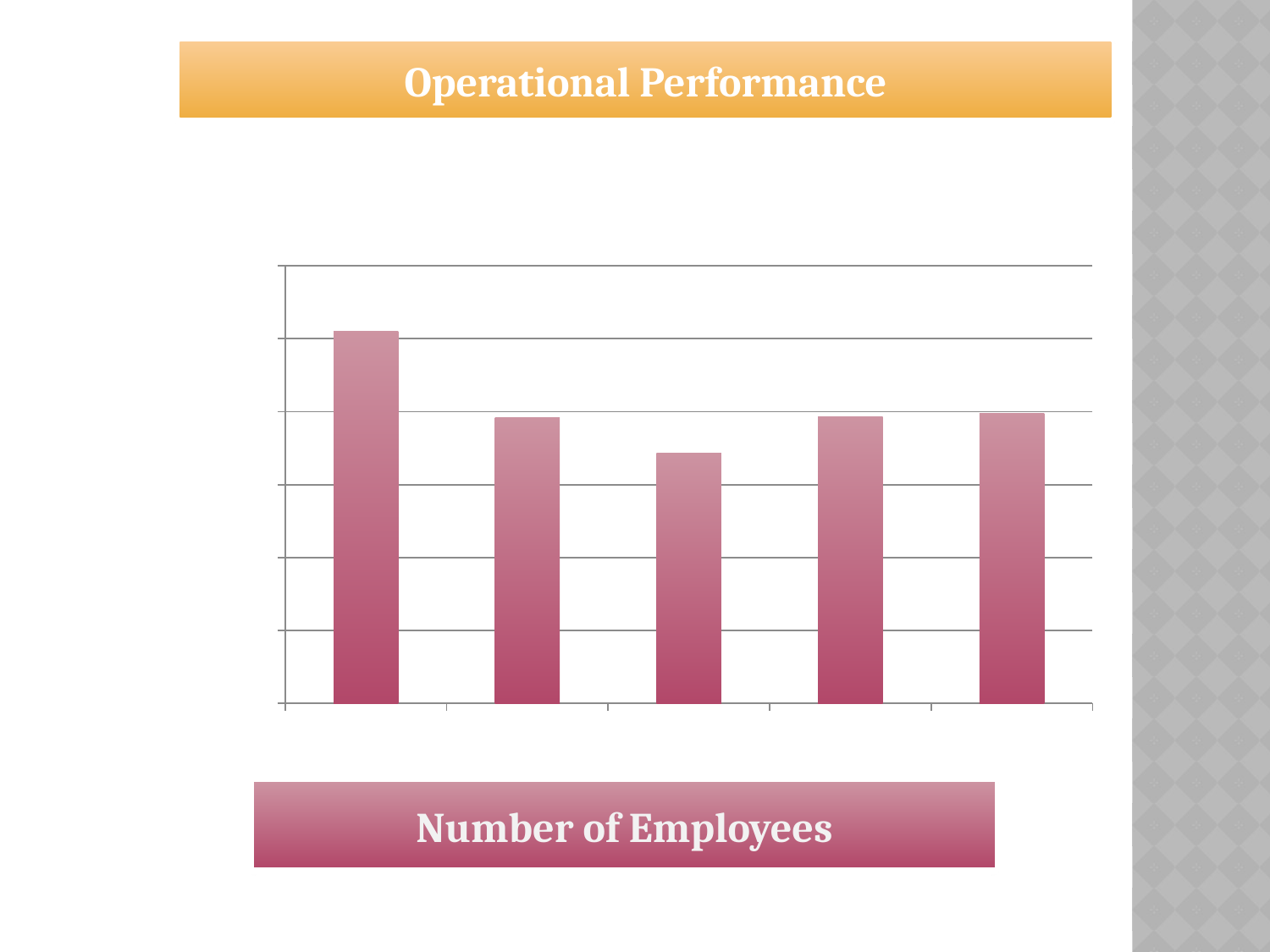
Which bar is the tallest in the chart? the first bar from the left Which bar is the shortest in the chart? the third bar from the left Which is taller, the third bar from the left or the fifth bar from the left? the fifth bar from the left What kind of chart is shown on the slide? bar chart What is the title shown at the top of the slide? Operational Performance How many bars does the chart show? 5 Which is taller, the first bar from the left or the third bar from the left? the first bar from the left What label appears in the banner below the chart? Number of Employees